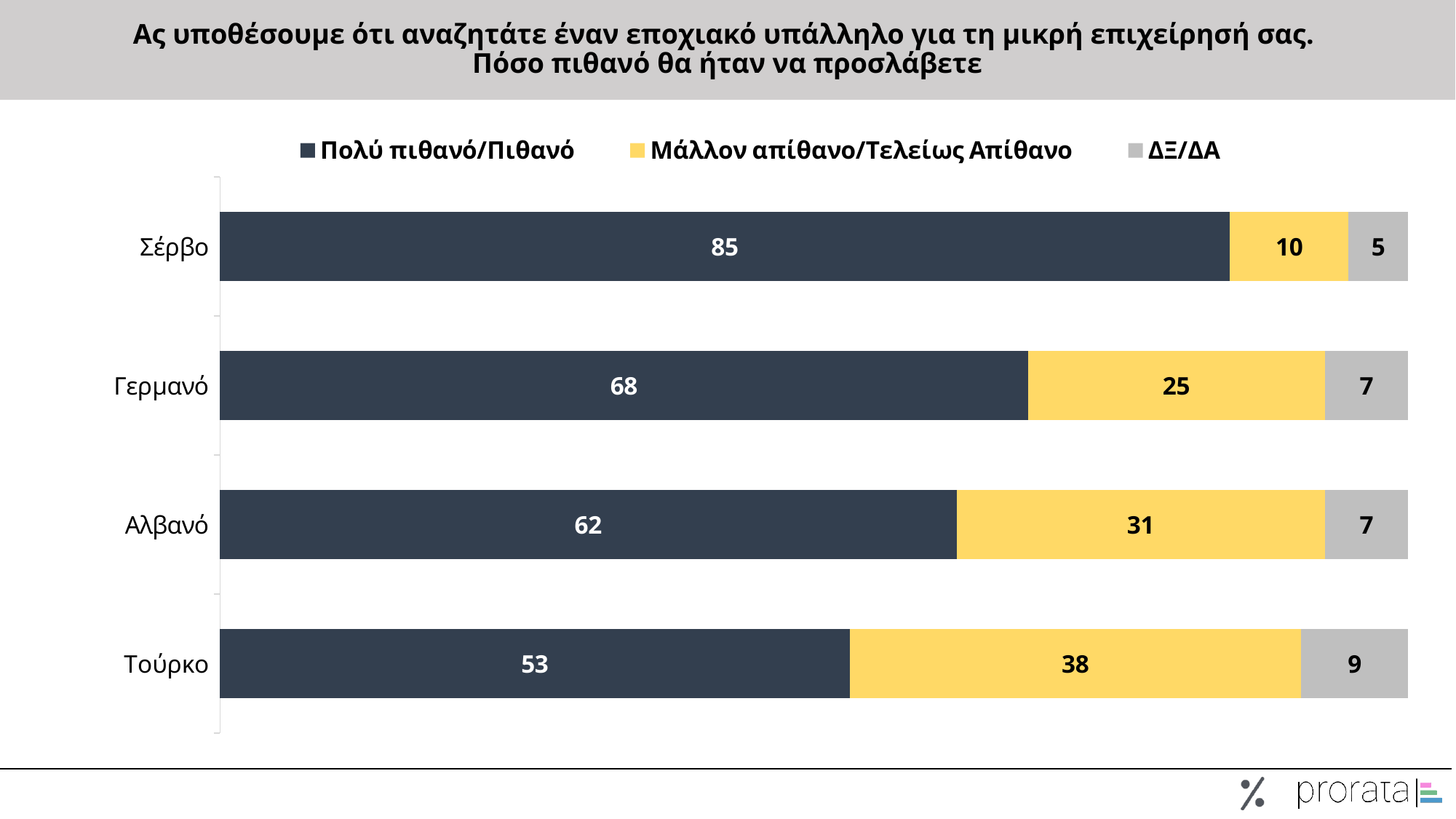
How many categories are shown on the chart? 4 What is the value of 'Μάλλον απίθανο/Τελείως Απίθανο' for Τούρκο? 38 What is the value of 'Πολύ πιθανό/Πιθανό' for Σέρβο? 85 Which category has the lowest value for 'Πολύ πιθανό/Πιθανό'? Τούρκο What kind of chart is shown on the slide? Stacked bar chart What is the total of the stacked bar for Τούρκο? 100 Which category has the highest value for 'Πολύ πιθανό/Πιθανό'? Σέρβο What is the value of 'ΔΞ/ΔΑ' for Γερμανό? 7 Which colour represents the 'ΔΞ/ΔΑ' series? Grey Which is larger: the 'Μάλλον απίθανο/Τελείως Απίθανο' value for Αλβανό or for Γερμανό? Αλβανό How many series does the legend list? 3 What is the difference between the 'Πολύ πιθανό/Πιθανό' values for Γερμανό and Αλβανό? 6